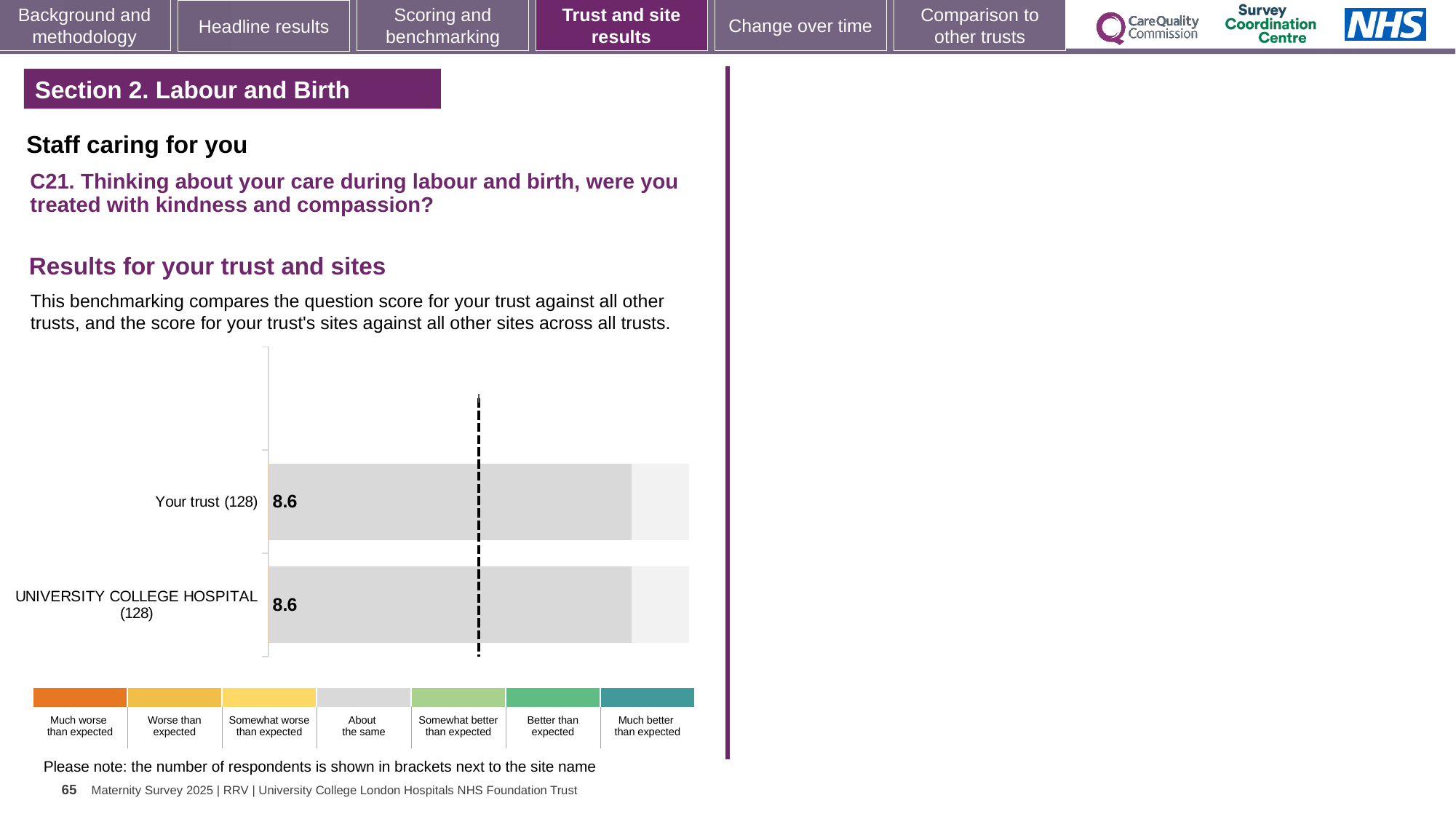
What is the difference between the score for Your trust and the score for UNIVERSITY COLLEGE HOSPITAL? 0 Is the score for Your trust higher, lower, or the same as the score for UNIVERSITY COLLEGE HOSPITAL? the same What kind of chart is shown on the slide? bar chart Which benchmark category in the colour key does the grey colour of the bars correspond to? About the same What is the score shown for Your trust (128)? 8.6 How many bars are plotted in the chart? 2 How many respondents are shown in brackets for Your trust? 128 What is the score shown for UNIVERSITY COLLEGE HOSPITAL (128)? 8.6 Which survey question does the chart report results for? C21. Thinking about your care during labour and birth, were you treated with kindness and compassion? How many respondents are shown in brackets for UNIVERSITY COLLEGE HOSPITAL? 128 How many benchmark categories are listed in the colour key below the chart? 7